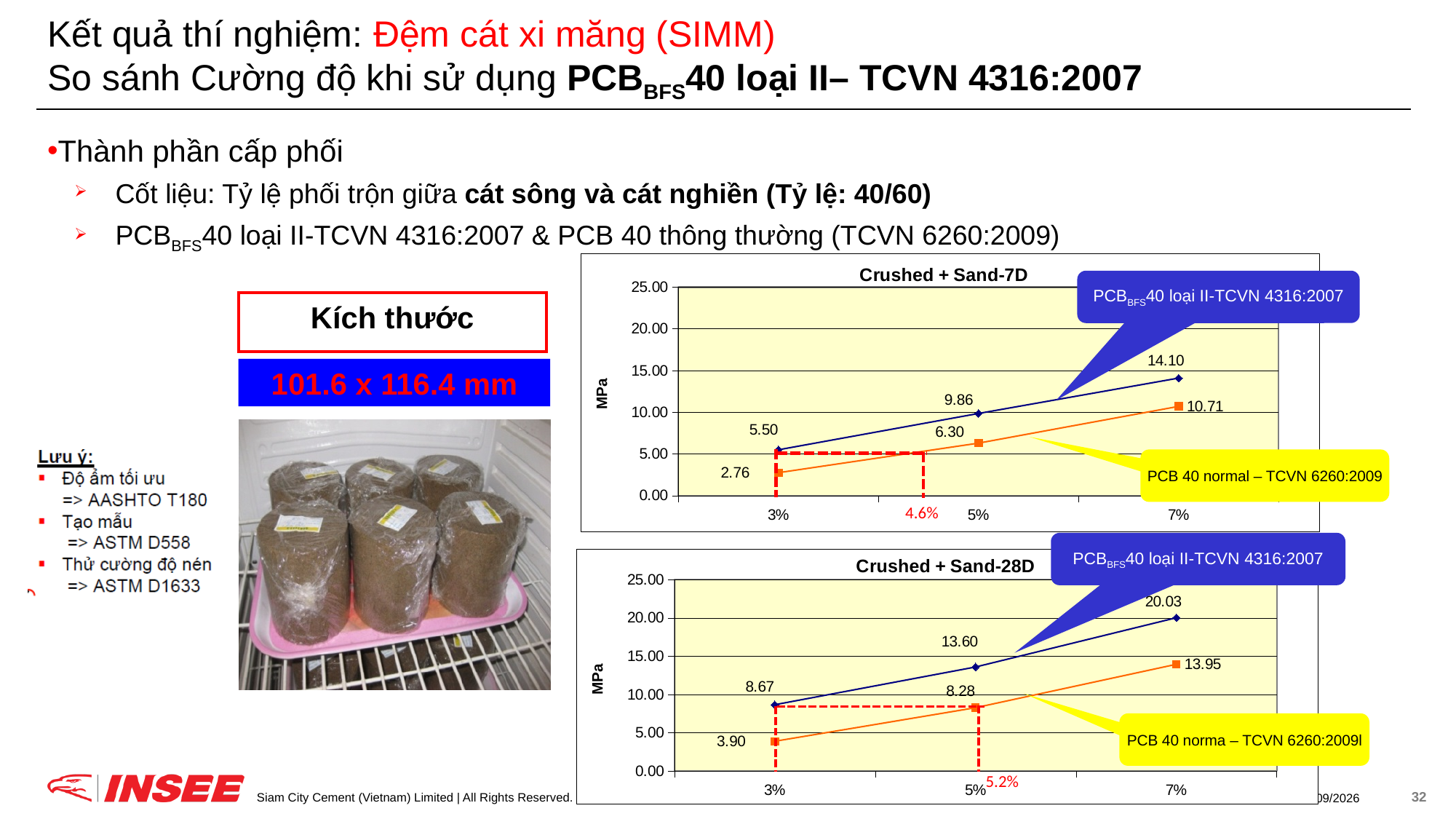
In the 'Crushed + Sand-28D' chart, do the values of PCB BFS 40 loại II-TCVN 4316:2007 rise or fall as the percentage increases? rise In the 'Crushed + Sand-7D' chart, what is the value for PCB BFS 40 loại II-TCVN 4316:2007 at 7%? 14.10 In the 'Crushed + Sand-28D' chart, what is the difference between the two series at 3%? 4.77 In the 'Crushed + Sand-7D' chart, what is the difference between the two series at 5%? 3.56 In the 'Crushed + Sand-7D' chart, what is the value for PCB 40 normal – TCVN 6260:2009 at 3%? 2.76 In the 'Crushed + Sand-7D' chart, how many percentage categories are shown on the x axis? 3 What type of chart is the 'Crushed + Sand-7D' chart? line chart In the 'Crushed + Sand-7D' chart, at which percentage is the PCB 40 normal – TCVN 6260:2009 value lowest? 3% In the 'Crushed + Sand-28D' chart, which series has the higher value at 7%? PCB BFS 40 loại II-TCVN 4316:2007 In the 'Crushed + Sand-28D' chart, what is the value for PCB 40 normal – TCVN 6260:2009 at 7%? 13.95 In the 'Crushed + Sand-28D' chart, at which percentage is the PCB BFS 40 loại II-TCVN 4316:2007 value highest? 7% In the 'Crushed + Sand-28D' chart, what is the value for PCB BFS 40 loại II-TCVN 4316:2007 at 5%? 13.60